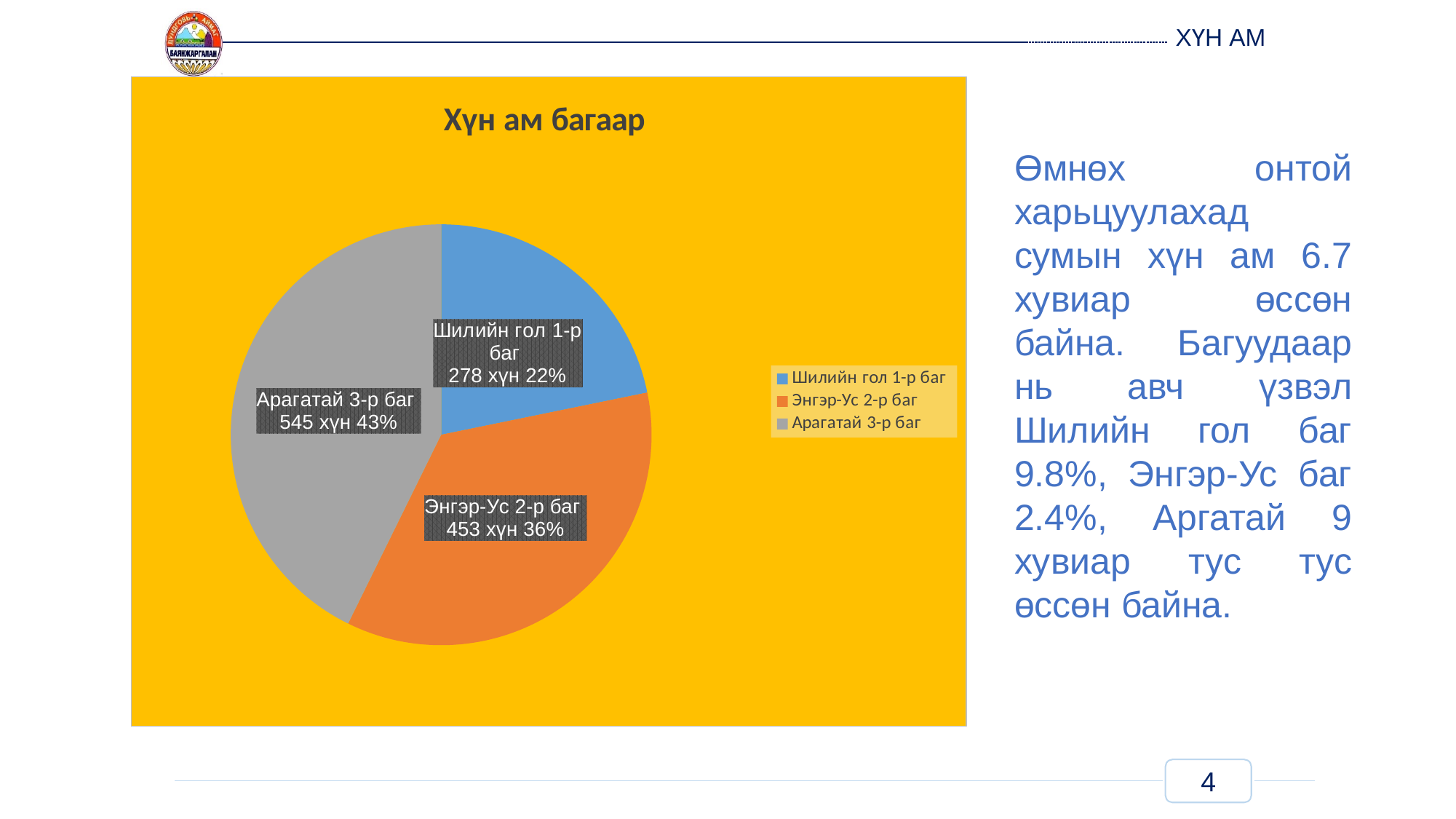
How many people are in Энгэр-Ус 2-р баг according to the chart? 453 хүн How many people are in Арагатай 3-р баг according to the chart? 545 хүн What is the title of the chart? Хүн ам багаар What kind of chart is shown on the slide? pie chart What share of the pie does Арагатай 3-р баг represent? 43% Which баг has the smallest population in the chart? Шилийн гол 1-р баг What is the difference in population between Арагатай 3-р баг and Энгэр-Ус 2-р баг? 92 хүн How many entries does the legend list? 3 How many slices does the pie chart have? 3 Which баг has the largest population in the chart? Арагатай 3-р баг How many people are in Шилийн гол 1-р баг according to the chart? 278 хүн What share of the pie does Шилийн гол 1-р баг represent? 22%